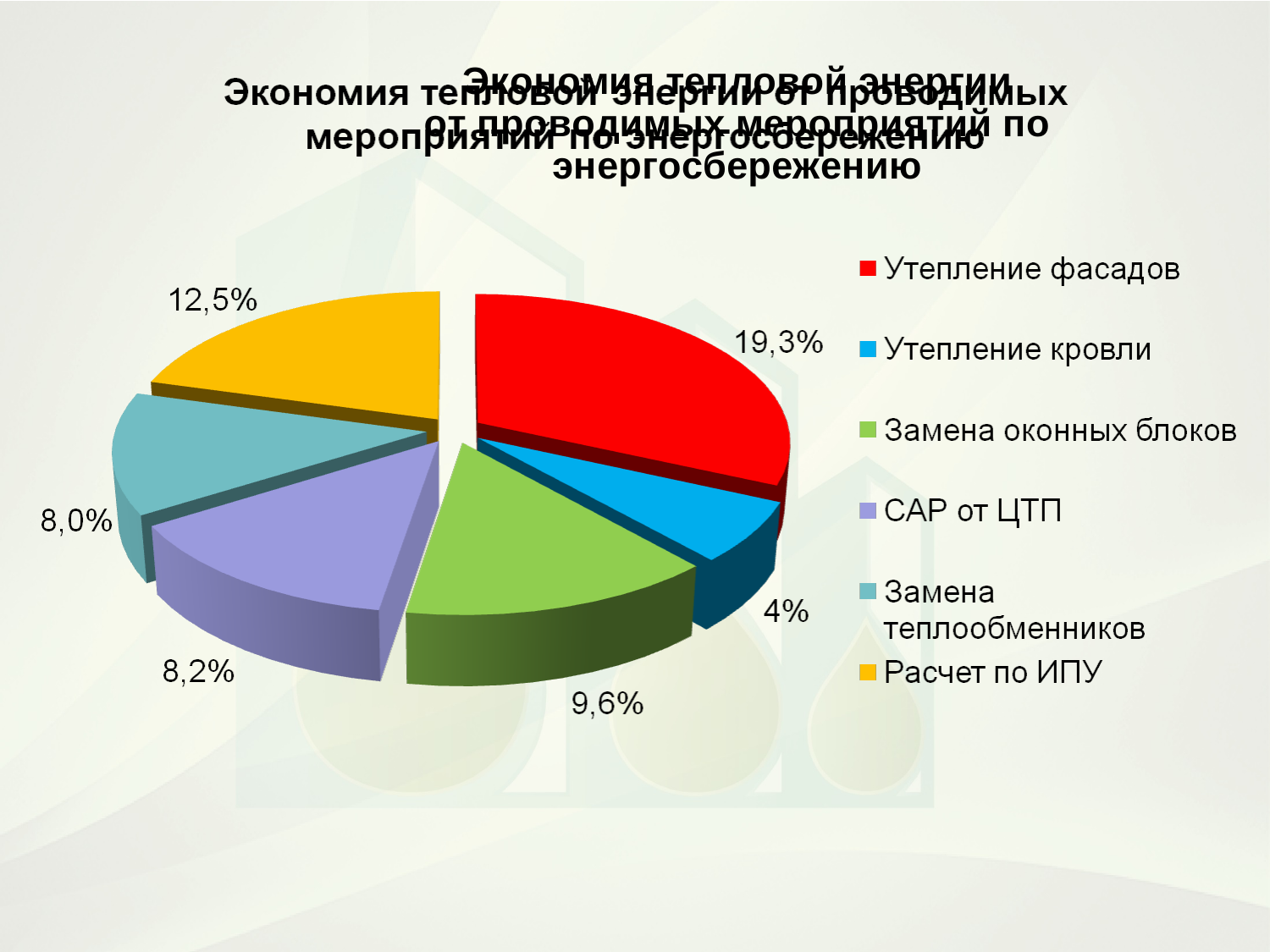
How many slices does the pie chart have? 6 How many entries does the legend list? 6 Which category has the largest slice of the pie? Утепление фасадов What is the value shown for Расчет по ИПУ? 12,5% What is the value shown for Утепление фасадов? 19,3% What is the value shown for Утепление кровли? 4% What colour is the slice for САР от ЦТП? Purple Which category has the smallest slice of the pie? Утепление кровли What is the value shown for Замена оконных блоков? 9,6% What is the difference between the values for Утепление фасадов and Утепление кровли? 15,3% What kind of chart is shown on the slide? Pie chart Which is larger, the value for Расчет по ИПУ or the value for Замена оконных блоков? Расчет по ИПУ